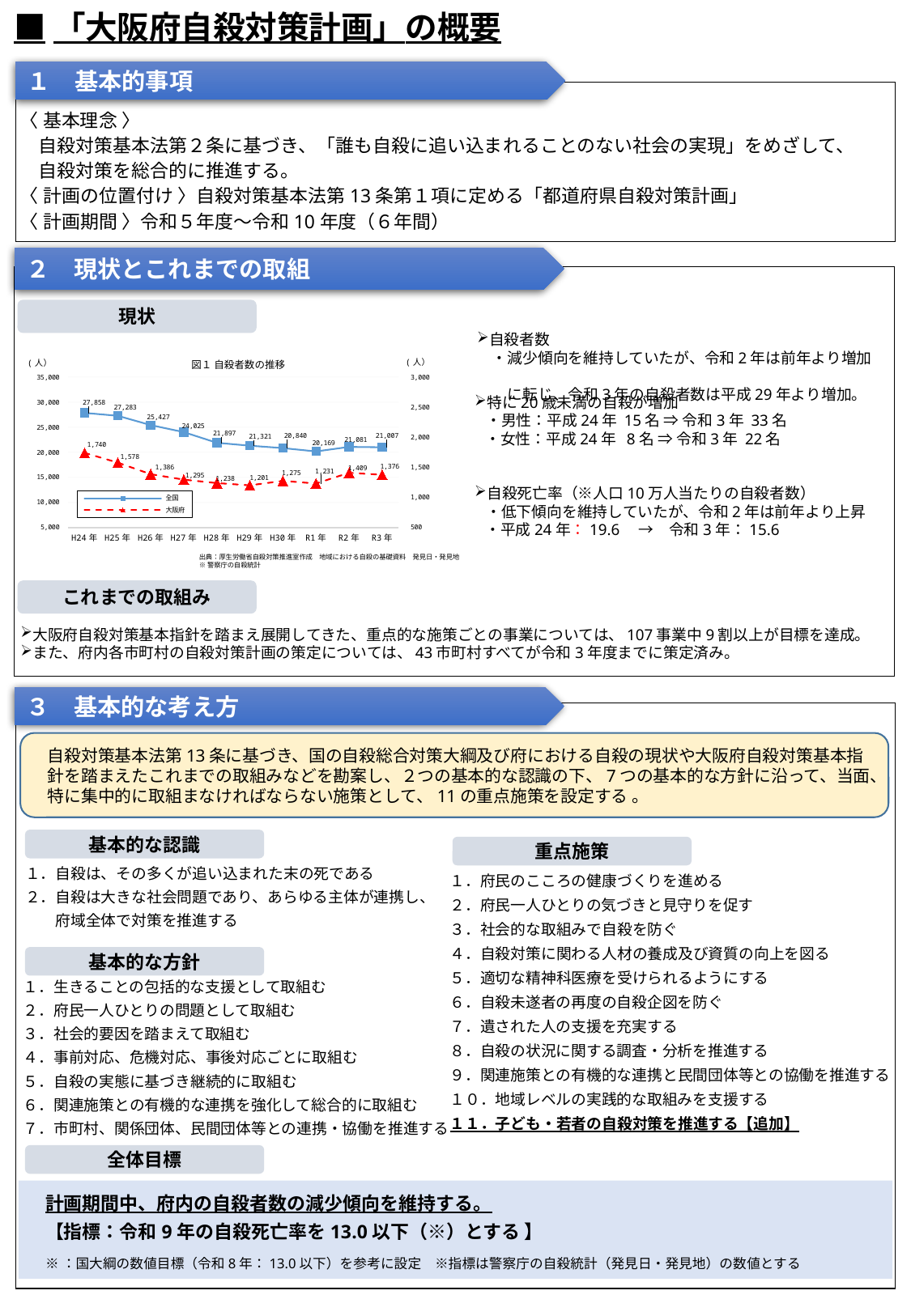
In 図1 自殺者数の推移, does the 全国 series generally rise or fall from H24年 to R1年? fall How many years are plotted along the x axis of 図1 自殺者数の推移? 10 In 図1 自殺者数の推移, what is the difference between the 大阪府 values for H24年 and R3年? 364 How many series does the legend of 図1 自殺者数の推移 list? 2 In 図1 自殺者数の推移, what is the 大阪府 value for R3年? 1,376 What is the title of the chart on the slide? 図1 自殺者数の推移 In 図1 自殺者数の推移, what is the 大阪府 value for H29年? 1,201 In 図1 自殺者数の推移, what is the 全国 value for H24年? 27,858 In 図1 自殺者数の推移, which year has the highest 大阪府 value? H24年 In 図1 自殺者数の推移, which year has the lowest 全国 value? R1年 What type of chart is 図1 自殺者数の推移? line chart In 図1 自殺者数の推移, which is larger, the 全国 value for R2年 or for R3年? R2年